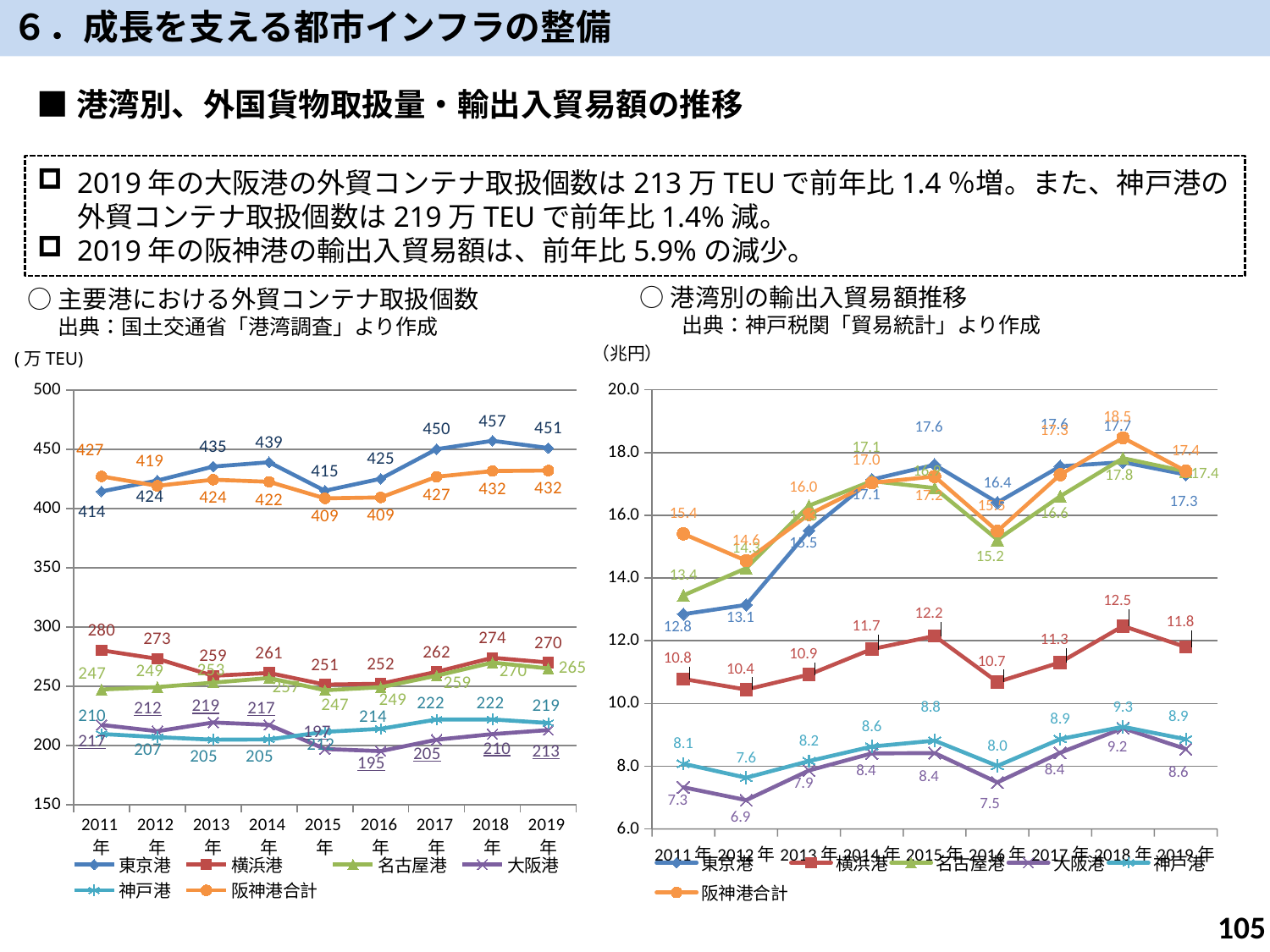
In the left chart (主要港における外貿コンテナ取扱個数), which port has the highest value in 2019年? 東京港 In the right chart (港湾別の輸出入貿易額推移), which is larger in 2019年, 神戸港 or 大阪港? 神戸港 In the left chart (主要港における外貿コンテナ取扱個数), what is the difference between the 横浜港 values for 2011年 and 2019年? 10 What kind of chart is the left chart (主要港における外貿コンテナ取扱個数)? line chart In the left chart (主要港における外貿コンテナ取扱個数), is the value for 大阪港 in 2016年 greater or less than 200? less In the right chart (港湾別の輸出入貿易額推移), how many years are shown on the x axis? 9 In the right chart (港湾別の輸出入貿易額推移), in which year is the 大阪港 value lowest? 2012年 In the left chart (主要港における外貿コンテナ取扱個数), what is the value for 阪神港合計 in 2015年? 409 In the left chart (主要港における外貿コンテナ取扱個数), how many series does the legend list? 6 In the left chart (主要港における外貿コンテナ取扱個数), what is the value for 東京港 in 2018年? 457 In the right chart (港湾別の輸出入貿易額推移), what is the value for 横浜港 in 2018年? 12.5 In the right chart (港湾別の輸出入貿易額推移), what is the value for 阪神港合計 in 2018年? 18.5